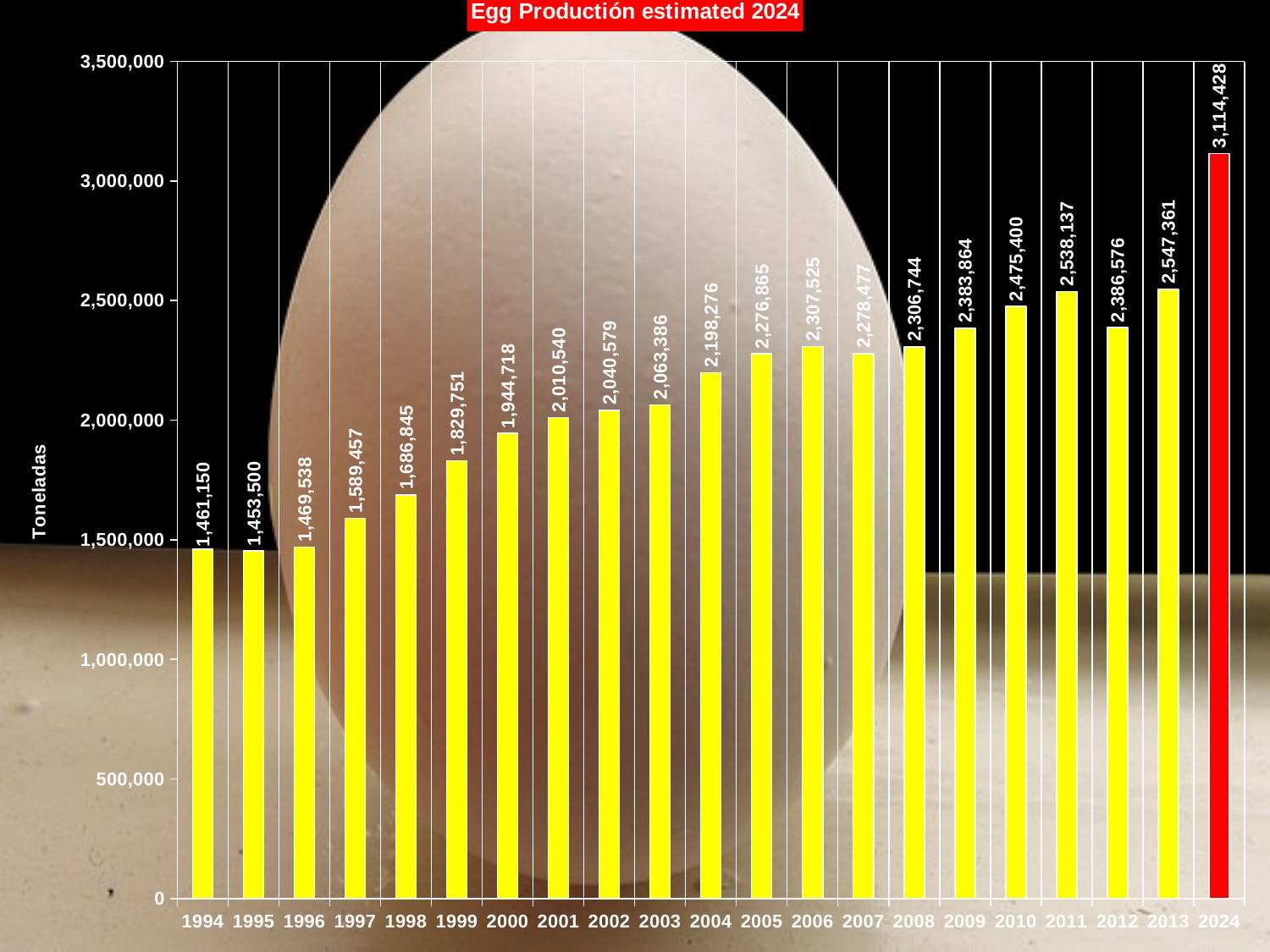
What is the egg production value for 2010? 2,475,400 Is the value for 2001 greater or less than 2,000,000? greater What is the difference between the 2011 value and the 2012 value? 151,561 How many years are shown on the x axis? 21 Which year has the lowest egg production? 1995 Which year has the highest egg production? 2024 What is the egg production value for 2024? 3,114,428 What is the egg production value for 1999? 1,829,751 What is the label on the y axis? Toneladas What is the difference between the 2024 value and the 2013 value? 567,067 What kind of chart is shown on the slide? bar chart Which is larger, the value for 2006 or the value for 2007? 2006